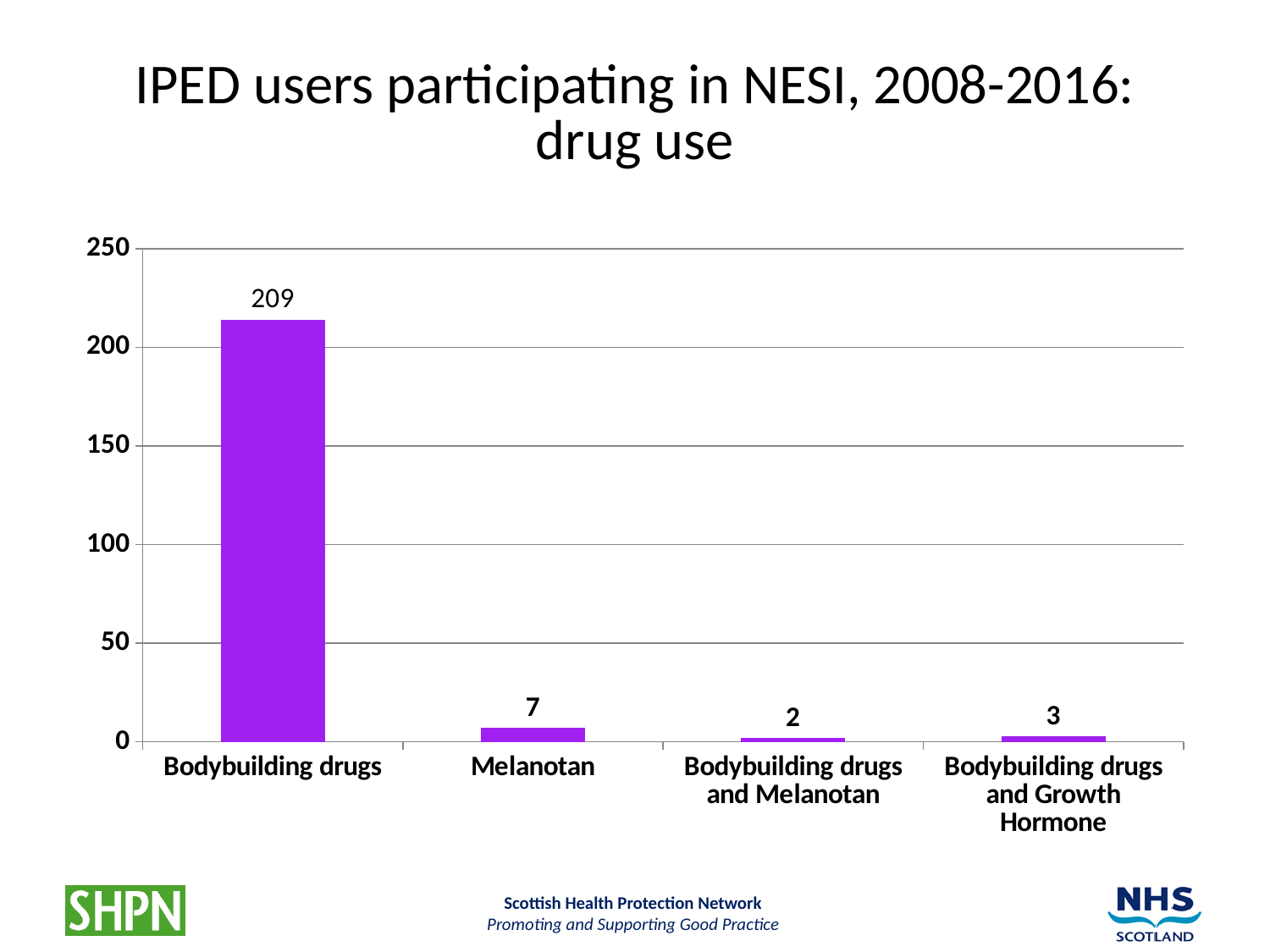
What is the value for Bodybuilding drugs and Melanotan? 2 Which is larger, the value for Melanotan or the value for Bodybuilding drugs and Growth Hormone? Melanotan How many categories are shown on the x axis? 4 What is the value for Bodybuilding drugs? 209 What is the title of the slide? IPED users participating in NESI, 2008-2016: drug use What kind of chart is shown on the slide? bar chart Which category has the lowest value? Bodybuilding drugs and Melanotan What is the value for Bodybuilding drugs and Growth Hormone? 3 What is the value for Melanotan? 7 Which category has the highest value? Bodybuilding drugs What is the difference between the values for Bodybuilding drugs and Melanotan? 202 Is the value for Bodybuilding drugs greater or less than 200? greater